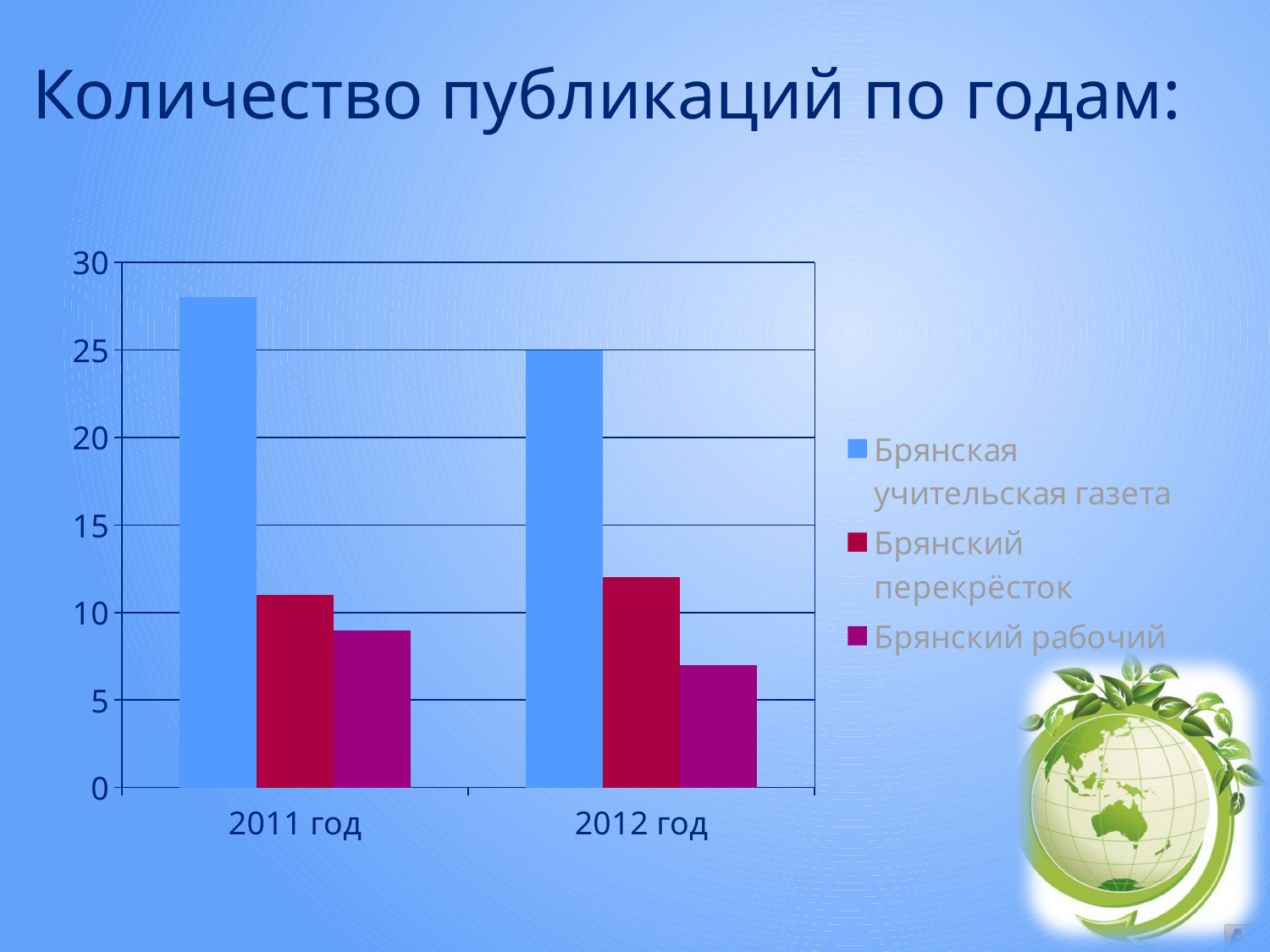
Which series has the highest value in 2011 год? Брянская учительская газета What kind of chart is shown on the slide? bar chart Which series has the lowest value in 2012 год? Брянский рабочий Is the value for Брянский рабочий in 2012 год greater or less than 10? less How many year categories are shown on the x axis? 2 Is the value for Брянский перекрёсток in 2012 год greater or less than 10? greater What is the value for Брянская учительская газета in 2012 год? 25 How many series does the legend list? 3 Does the value for Брянская учительская газета rise or fall from 2011 год to 2012 год? fall Is the value for Брянский рабочий in 2011 год greater or less than 10? less What is the title of the chart on the slide? Количество публикаций по годам: